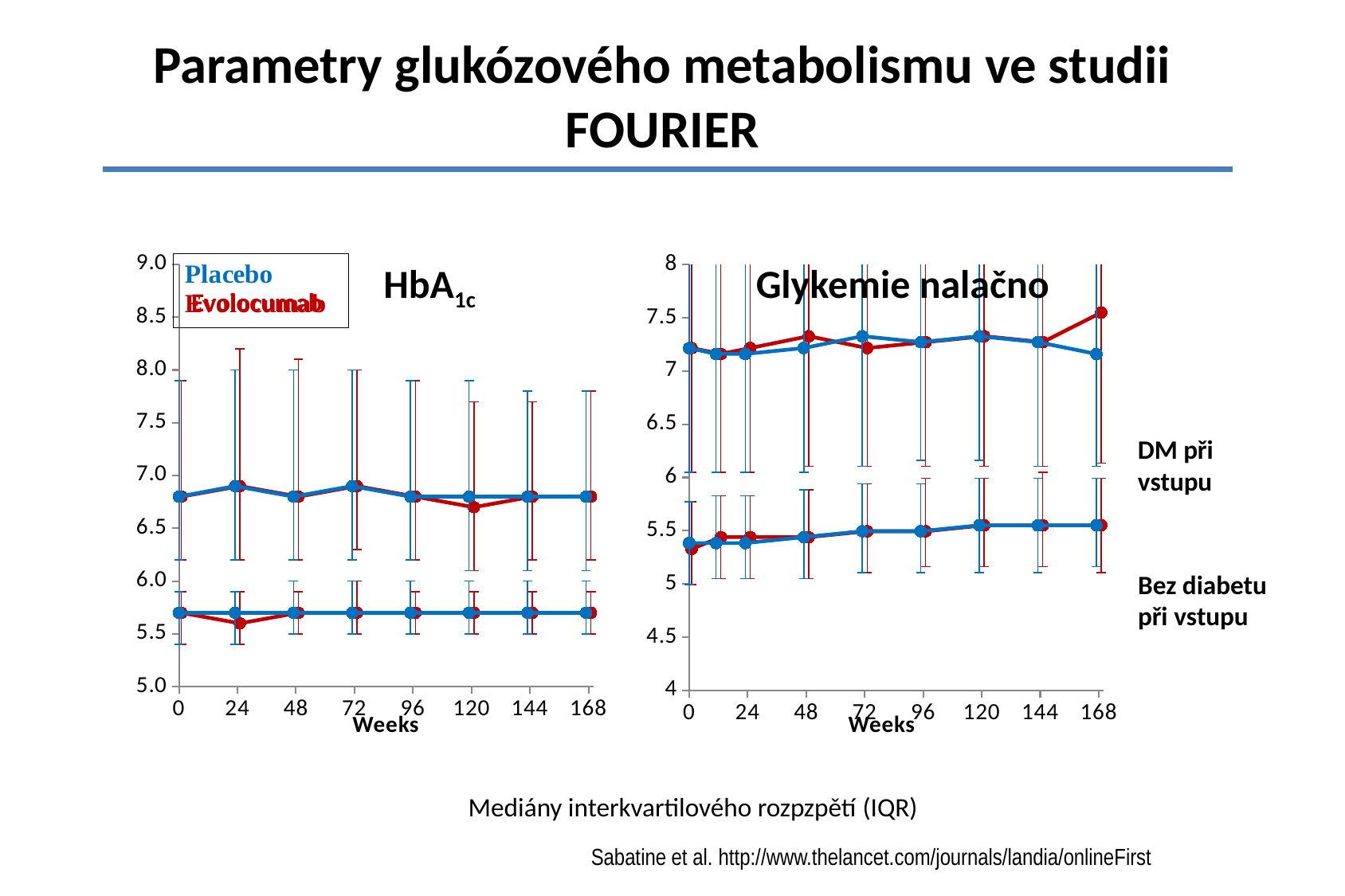
How many week labels are shown on the x axis of the HbA1c chart? 8 How many series does the legend on the HbA1c chart list? 2 In the HbA1c chart, which group has the higher value at week 0, DM při vstupu or Bez diabetu při vstupu? DM při vstupu In the HbA1c chart, is the value for the Bez diabetu při vstupu group at week 0 greater or less than 6.0? less In the Glykemie nalačno chart, at which week does the Evolocumab line for the DM při vstupu group reach its highest value? 168 What kind of chart is the HbA1c chart on the left? line chart In the HbA1c chart, is the value for the DM při vstupu group at week 0 greater or less than 6.5? greater In the Glykemie nalačno chart, is the value for the DM při vstupu group at week 0 greater or less than 7? greater In the Glykemie nalačno chart, does the Bez diabetu při vstupu line rise or fall from week 0 to week 168? rise In the HbA1c chart, which colour represents Placebo? blue What is the title of the chart on the right? Glykemie nalačno